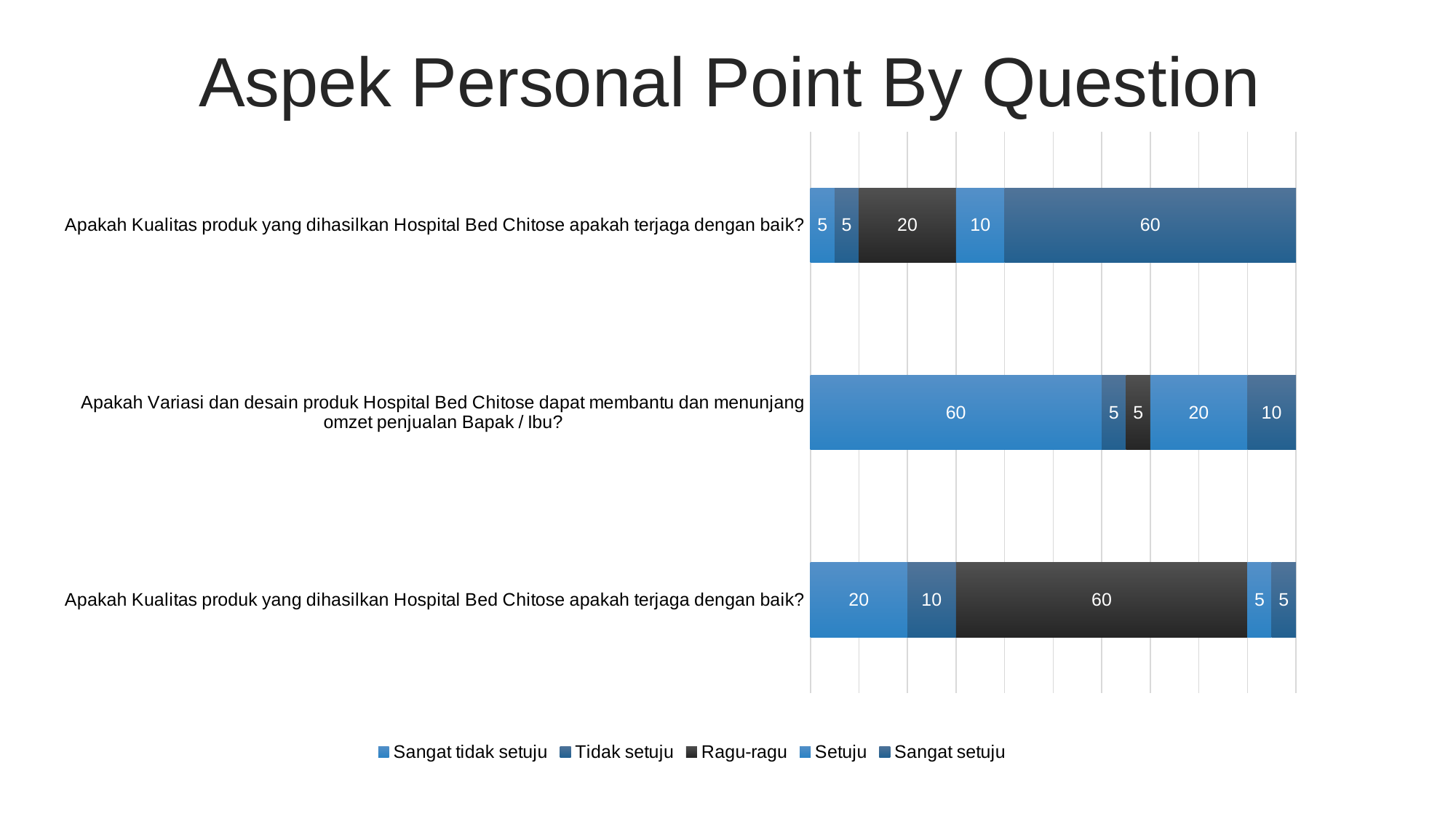
Which series has the largest value in the bar for 'Apakah Variasi dan desain produk Hospital Bed Chitose dapat membantu dan menunjang omzet penjualan Bapak / Ibu?'? Sangat tidak setuju What is the value for 'Setuju' in the bar for 'Apakah Variasi dan desain produk Hospital Bed Chitose dapat membantu dan menunjang omzet penjualan Bapak / Ibu?'? 20 What is the total of the stacked bar for 'Apakah Variasi dan desain produk Hospital Bed Chitose dapat membantu dan menunjang omzet penjualan Bapak / Ibu?'? 100 What is the value for 'Sangat tidak setuju' in the bar for 'Apakah Variasi dan desain produk Hospital Bed Chitose dapat membantu dan menunjang omzet penjualan Bapak / Ibu?'? 60 In the bottom bar of the chart, what is the value for 'Ragu-ragu'? 60 In the bar for 'Apakah Variasi dan desain produk Hospital Bed Chitose dapat membantu dan menunjang omzet penjualan Bapak / Ibu?', what is the difference between the 'Setuju' value and the 'Sangat setuju' value? 10 How many series does the legend list? 5 What kind of chart is shown on the slide? Stacked bar chart In the bottom bar of the chart, which is larger: the value for 'Sangat tidak setuju' or the value for 'Tidak setuju'? Sangat tidak setuju What is the total of the top stacked bar in the chart? 100 How many question categories (bars) are plotted in the chart? 3 In the top bar of the chart, what is the value for 'Sangat setuju'? 60